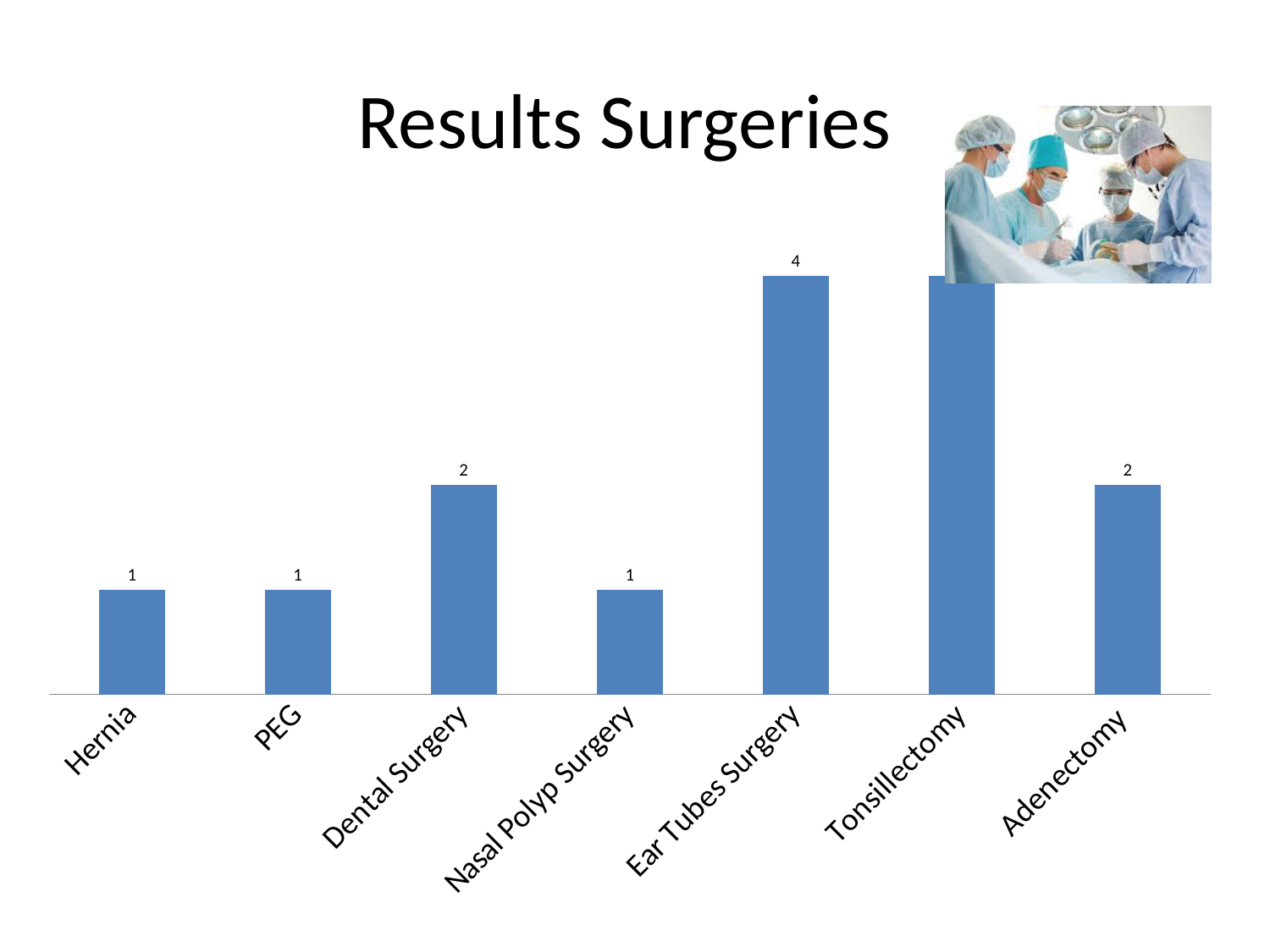
Which is larger, the value for Adenectomy or the value for Hernia? Adenectomy What is the value for Hernia? 1 What is the value for Dental Surgery? 2 What is the difference between the value for Ear Tubes Surgery and the value for Dental Surgery? 2 What is the difference between the value for Adenectomy and the value for PEG? 1 What is the value for Adenectomy? 2 What is the value for Nasal Polyp Surgery? 1 What kind of chart is shown on the slide? bar chart What is the value for Ear Tubes Surgery? 4 Which is larger, the value for Ear Tubes Surgery or the value for Dental Surgery? Ear Tubes Surgery How many categories are shown on the x axis of the chart? 7 What is the value for PEG? 1